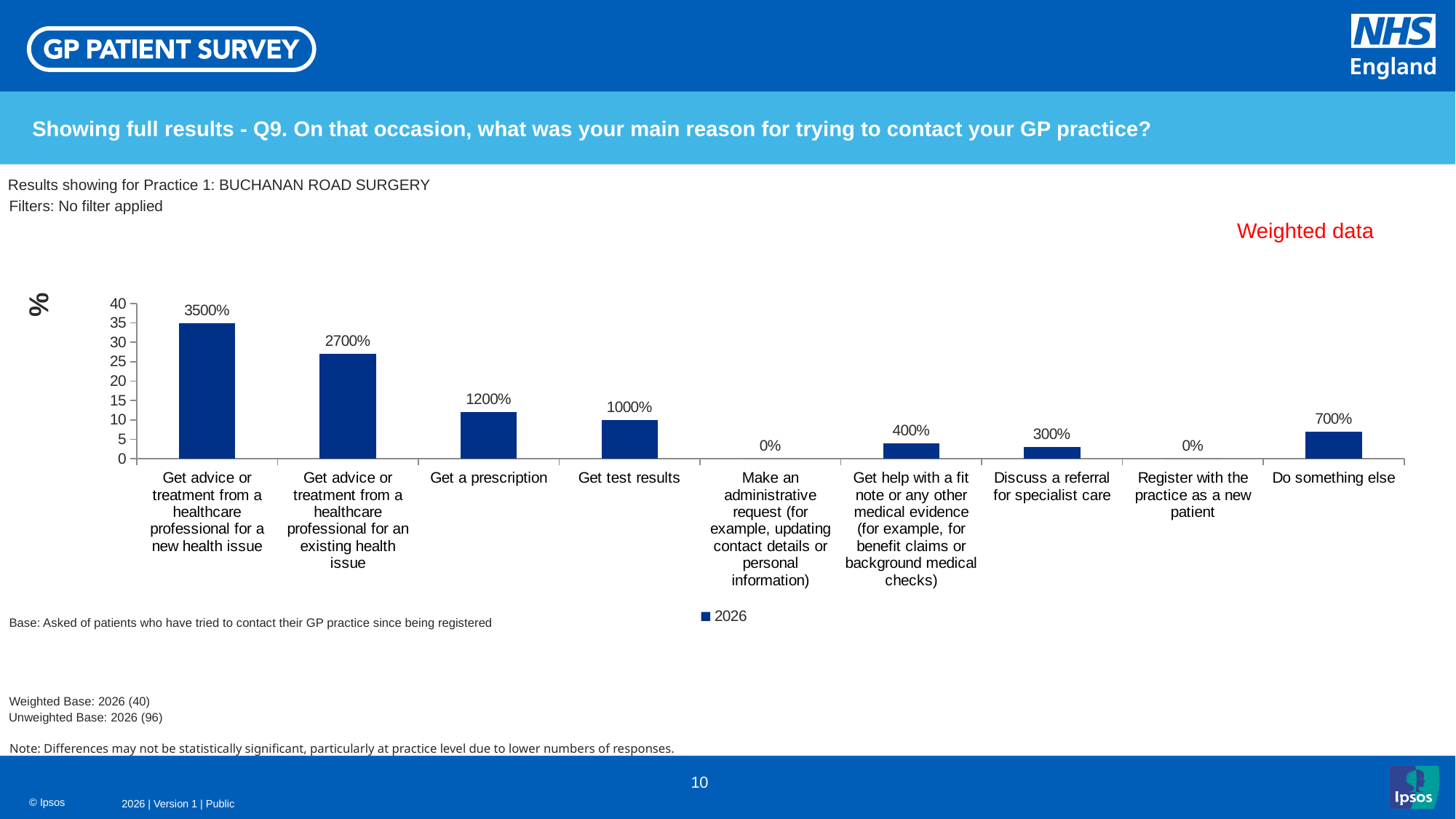
What kind of chart is shown on the slide? Bar chart What is the value shown for "Get a prescription"? 1200% What is the value shown for "Register with the practice as a new patient"? 0% Which category has the highest value? Get advice or treatment from a healthcare professional for a new health issue How many series does the legend list? 1 What is the difference between the values for "Get advice or treatment from a healthcare professional for a new health issue" and "Get advice or treatment from a healthcare professional for an existing health issue"? 800% Which is larger, the value for "Get help with a fit note or any other medical evidence" or the value for "Do something else"? Do something else What is the value shown for "Do something else"? 700% How many categories are shown on the x axis? 9 What is the value shown for "Discuss a referral for specialist care"? 300% What is the value shown for "Get test results"? 1000% What series name is shown in the legend? 2026